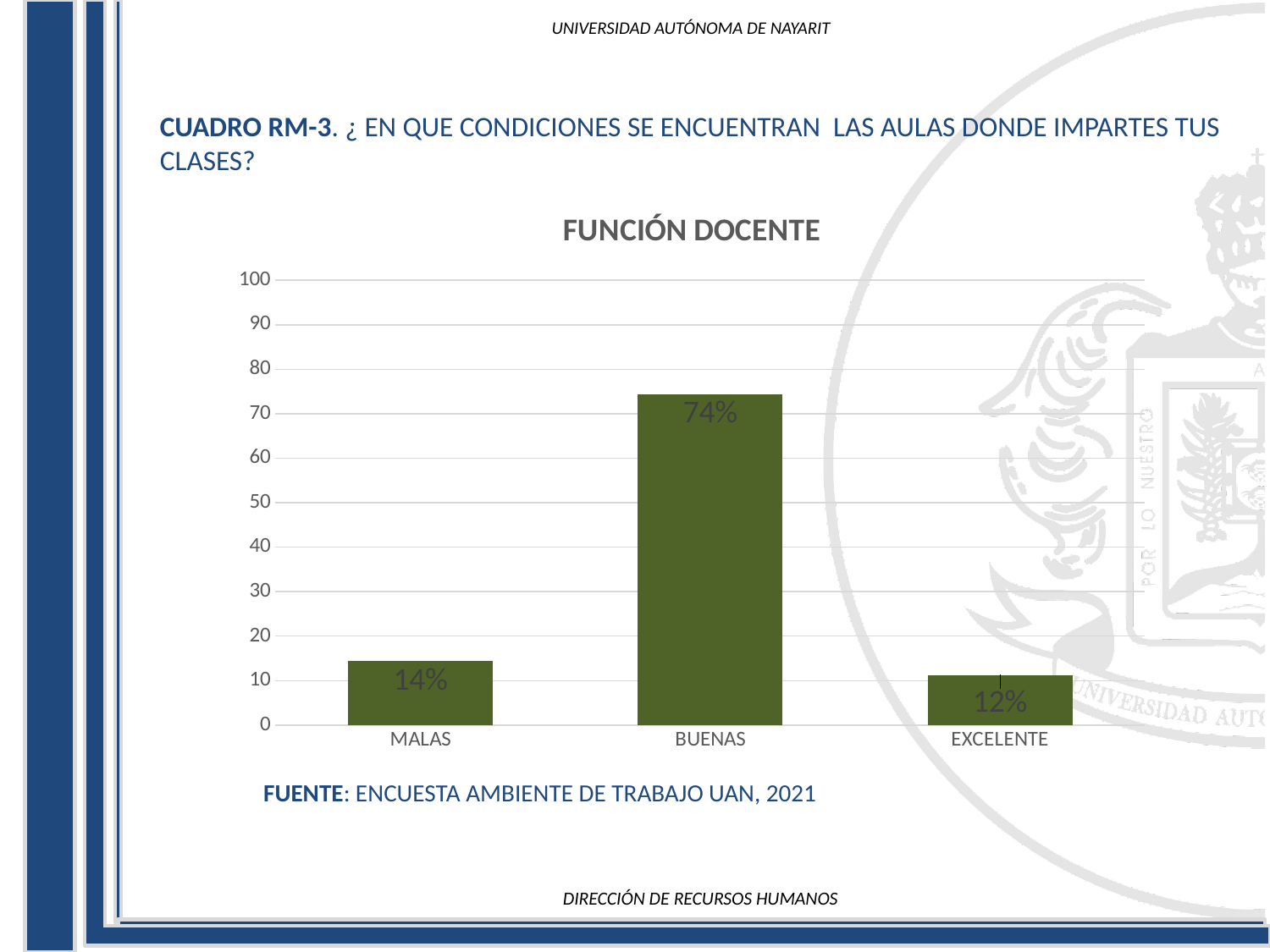
Which category has the highest value? BUENAS What is the value for MALAS? 14% What kind of chart is shown on the slide? bar chart What is the value for BUENAS? 74% Which category has the lowest value? EXCELENTE How many categories are shown on the x axis? 3 What is the value for EXCELENTE? 12% What is the difference between the values for MALAS and EXCELENTE? 2% Is the value for BUENAS greater or less than 70? greater What is the difference between the values for BUENAS and MALAS? 60% Which is larger, the value for MALAS or the value for BUENAS? BUENAS What is the title of the chart? FUNCIÓN DOCENTE